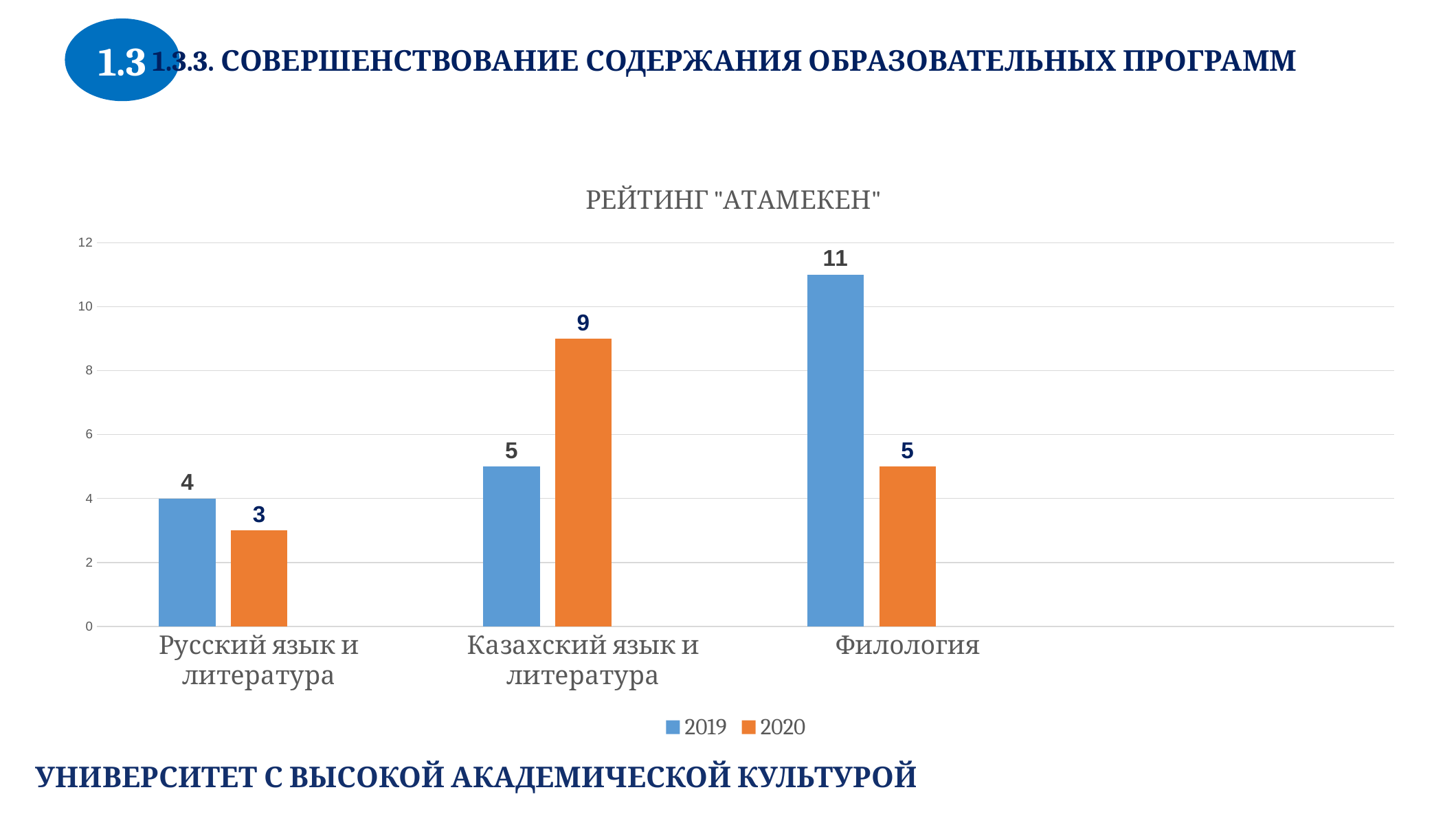
What is the difference between the 2019 and 2020 values for Филология? 6 What is the title of the chart? РЕЙТИНГ "АТАМЕКЕН" Which category has the highest 2019 value? Филология Which category has the lowest 2020 value? Русский язык и литература Which is larger for Казахский язык и литература: the 2019 value or the 2020 value? 2020 How many series does the legend list? 2 Which colour represents the 2020 series in the legend? Orange What is the 2019 value for Филология? 11 What is the 2020 value for Казахский язык и литература? 9 How many categories are shown on the x axis? 3 What kind of chart is shown? Bar chart What is the 2020 value for Русский язык и литература? 3